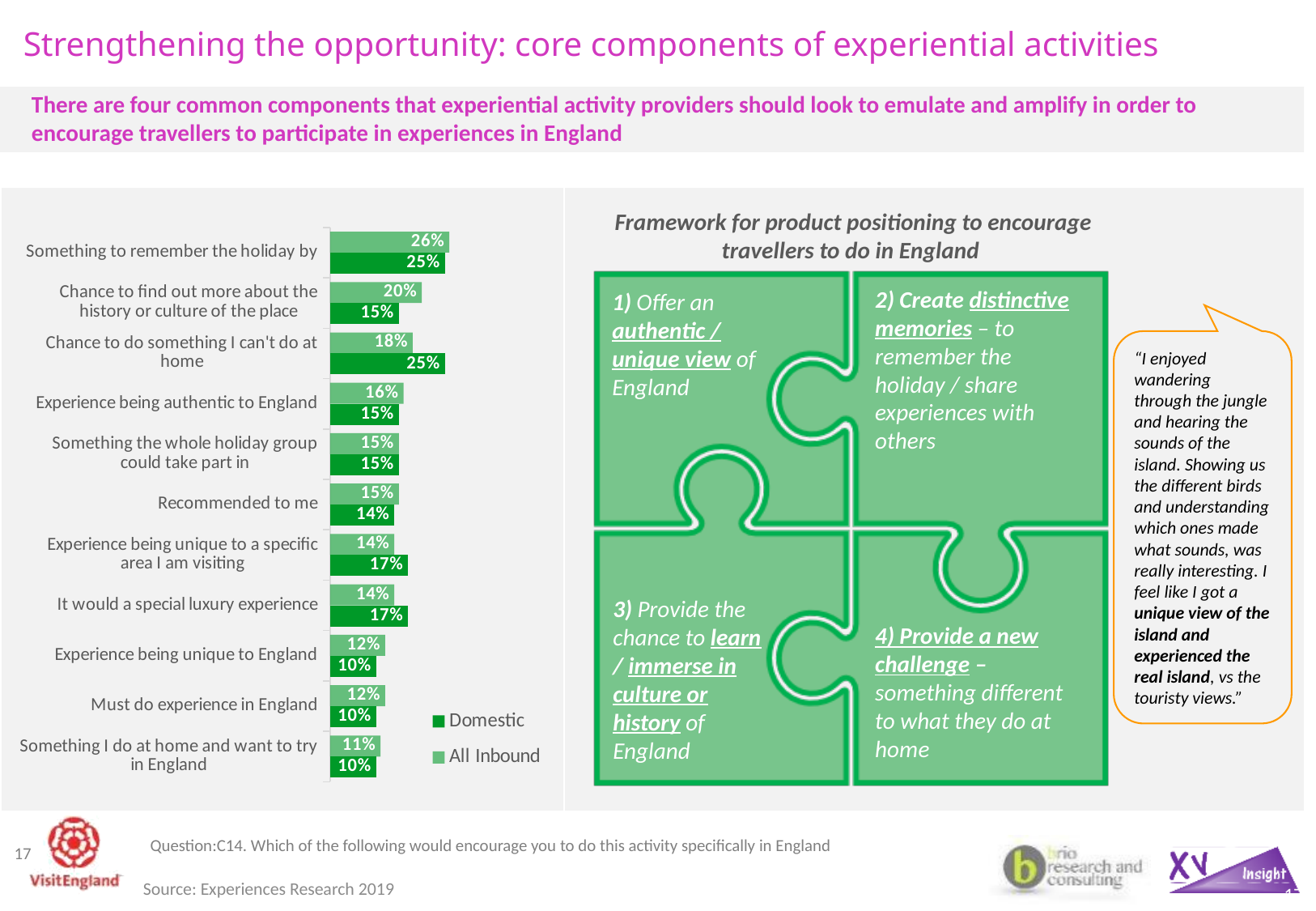
What is the All Inbound value for "It would a special luxury experience"? 14% Which category has the lowest All Inbound value? Something I do at home and want to try in England What is the Domestic value for "Chance to do something I can't do at home"? 25% What is the difference between the Domestic and All Inbound values for "Chance to do something I can't do at home"? 7% What is the All Inbound value for "Something to remember the holiday by"? 26% How many categories are shown in the bar chart? 11 How many series does the chart legend list? 2 What is the Domestic value for "Chance to find out more about the history or culture of the place"? 15% Which category has the highest All Inbound value? Something to remember the holiday by What type of chart is shown on the slide? Bar chart For "Chance to find out more about the history or culture of the place", which is larger: the Domestic or the All Inbound value? All Inbound Which series is shown in dark green in the chart legend? Domestic